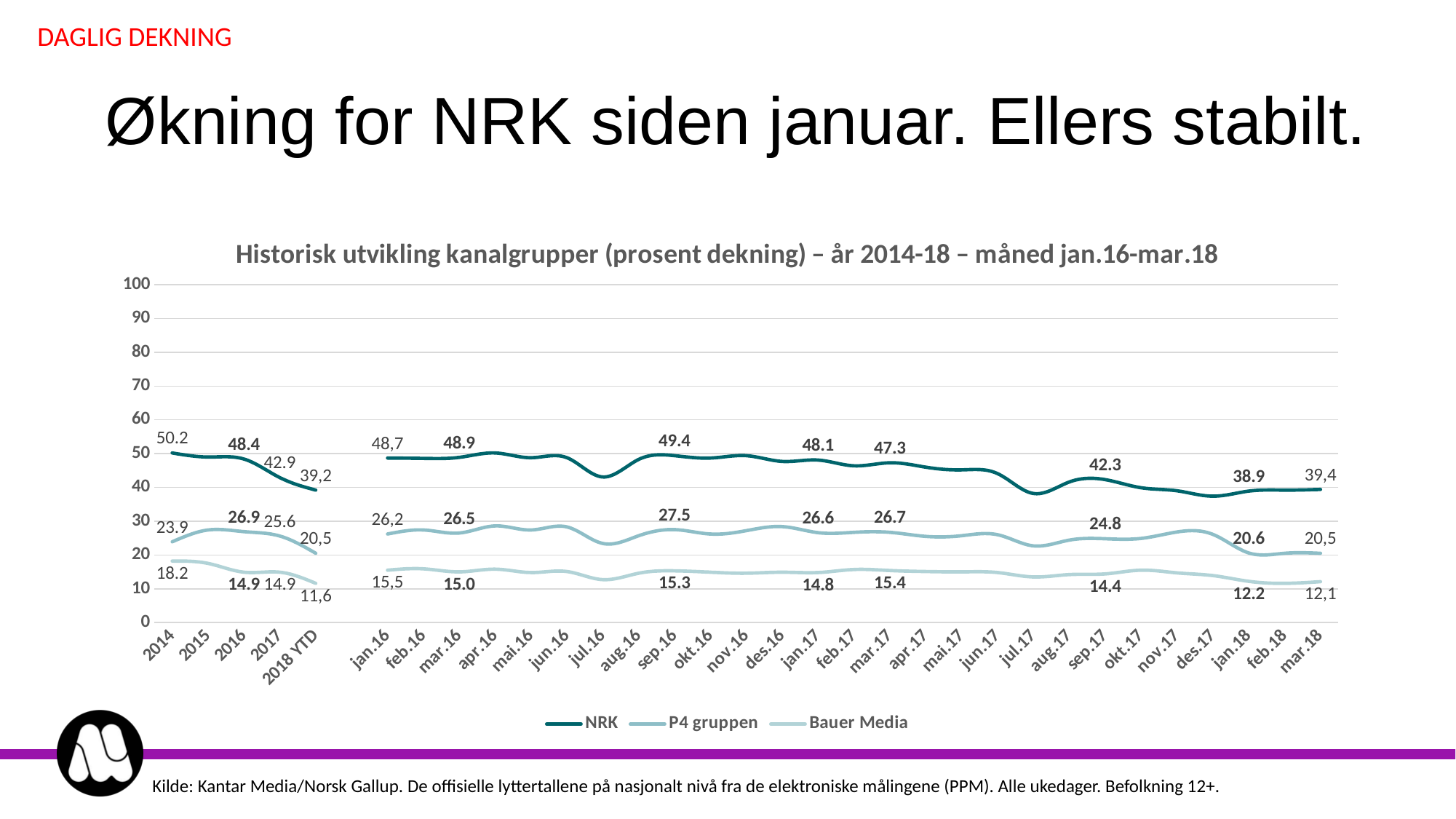
What is the Bauer Media value for mar.18? 12,1 Which is larger, the P4 gruppen value for jan.17 or for jan.18? jan.17 Is the NRK value for jul.17 greater or less than 40? less What type of chart is shown on the slide? line chart How many series does the legend list? 3 Does the NRK line rise or fall from sep.16 to jan.18? fall Which series has the highest value at mar.17? NRK What is the difference between the NRK values for 2014 and 2018 YTD? 11.0 Which series has the lowest value at 2018 YTD? Bauer Media What is the NRK value for jan.18? 38.9 What is the P4 gruppen value for sep.16? 27.5 What is the NRK value for 2014? 50.2